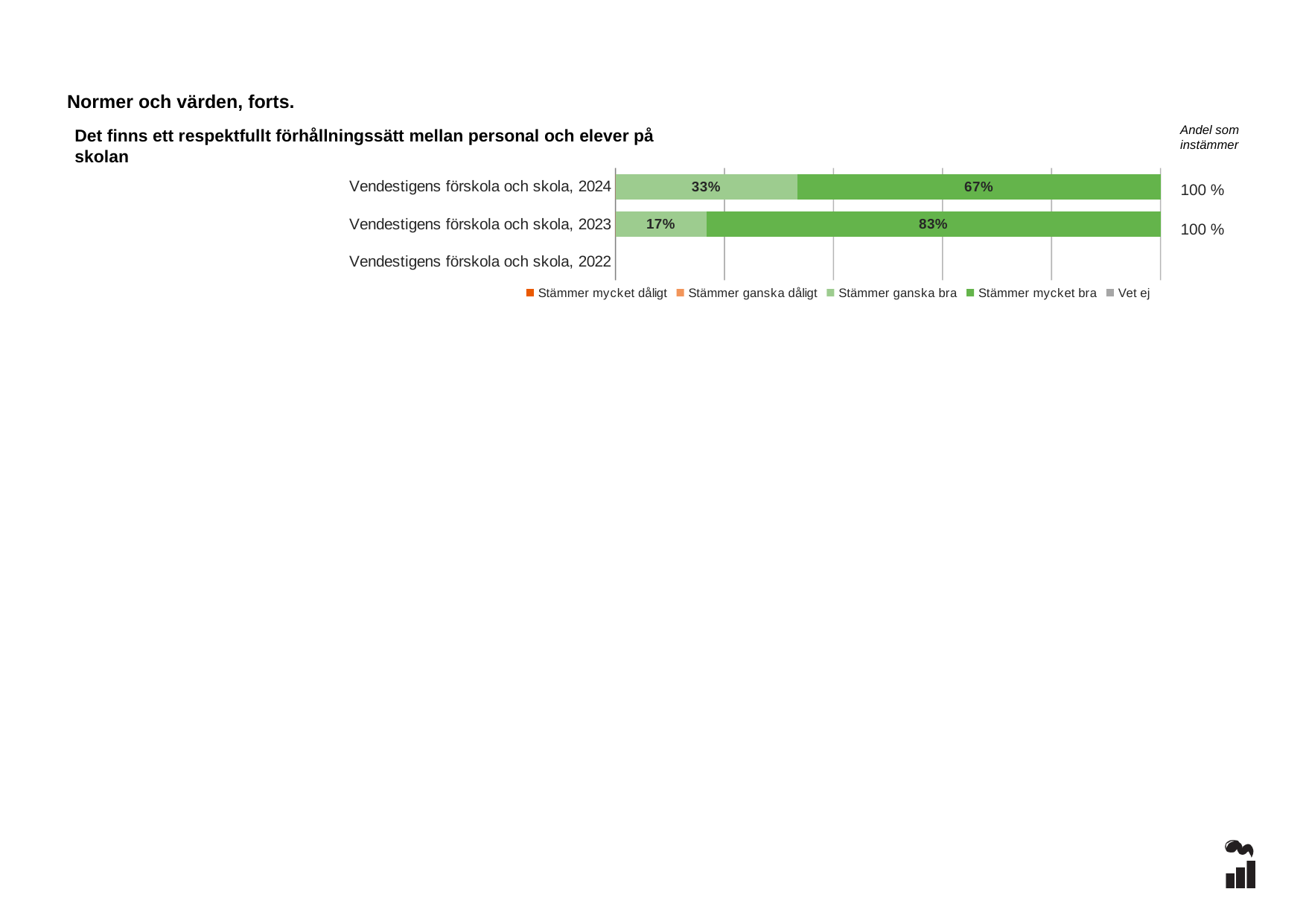
What is the difference between the "Stämmer mycket bra" values for 2023 and 2024? 16% Which year has the higher value for "Stämmer mycket bra", 2024 or 2023? 2023 What is the title of the chart? Det finns ett respektfullt förhållningssätt mellan personal och elever på skolan How many series does the legend list? 5 What is the value for "Stämmer ganska bra" for Vendestigens förskola och skola, 2024? 33% What is the value for "Stämmer mycket bra" for Vendestigens förskola och skola, 2023? 83% What is the "Andel som instämmer" value shown for Vendestigens förskola och skola, 2024? 100 % What kind of chart is shown on the slide? Stacked bar chart What is the difference between the "Stämmer ganska bra" values for 2024 and 2023? 16% How many category rows are shown on the chart? 3 What is the value for "Stämmer mycket bra" for Vendestigens förskola och skola, 2024? 67% What is the value for "Stämmer ganska bra" for Vendestigens förskola och skola, 2023? 17%